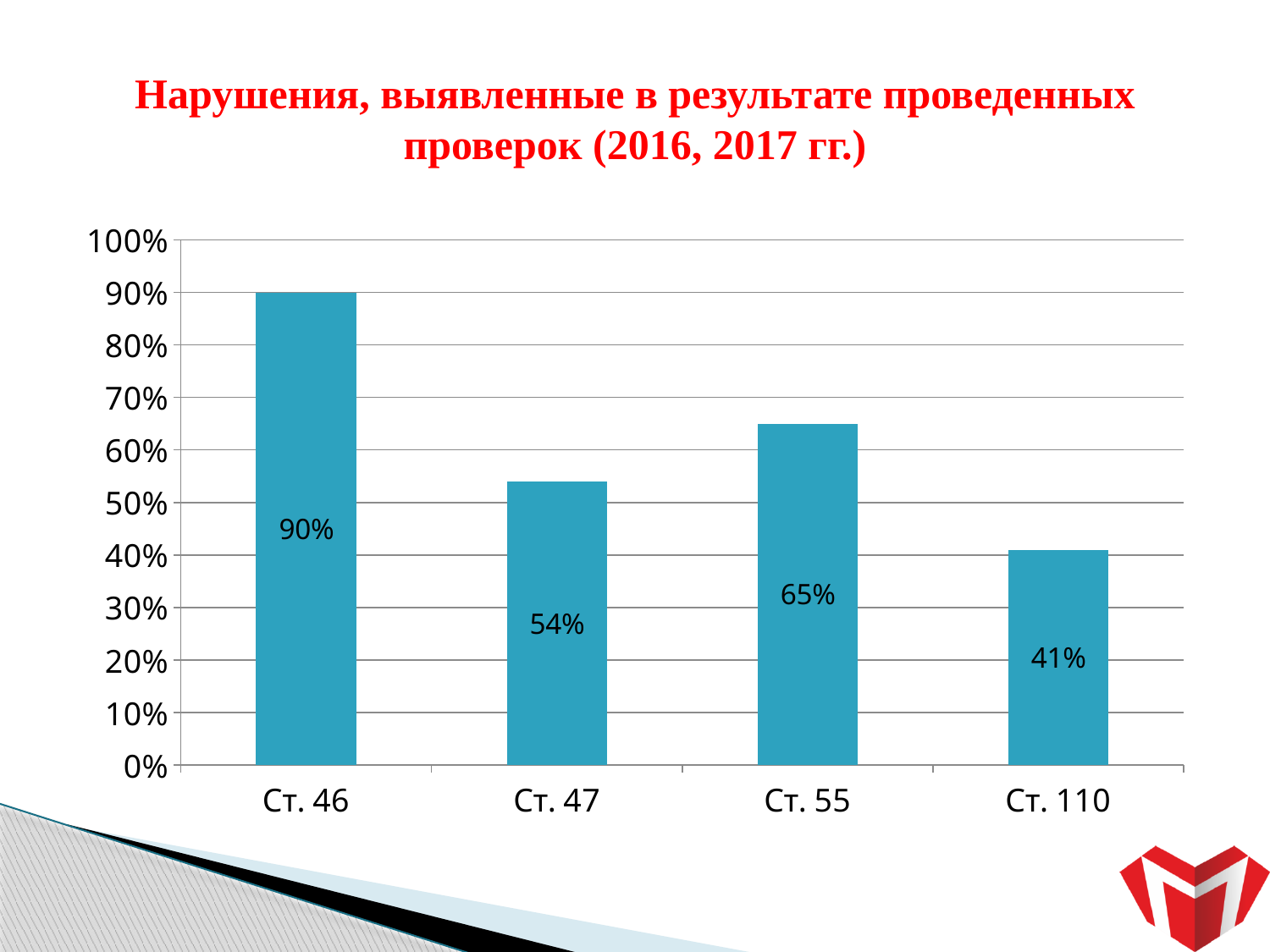
What kind of chart is shown on the slide? bar chart Is the value for Ст. 110 greater or less than 50%? less What is the difference between the values for Ст. 46 and Ст. 110? 49% What is the difference between the values for Ст. 55 and Ст. 47? 11% What is the value for Ст. 55? 65% What is the value for Ст. 46? 90% How many categories are shown on the x axis? 4 What is the value for Ст. 47? 54% Which category has the highest value? Ст. 46 Which category has the lowest value? Ст. 110 Which is larger, the value for Ст. 47 or the value for Ст. 55? Ст. 55 What is the value for Ст. 110? 41%